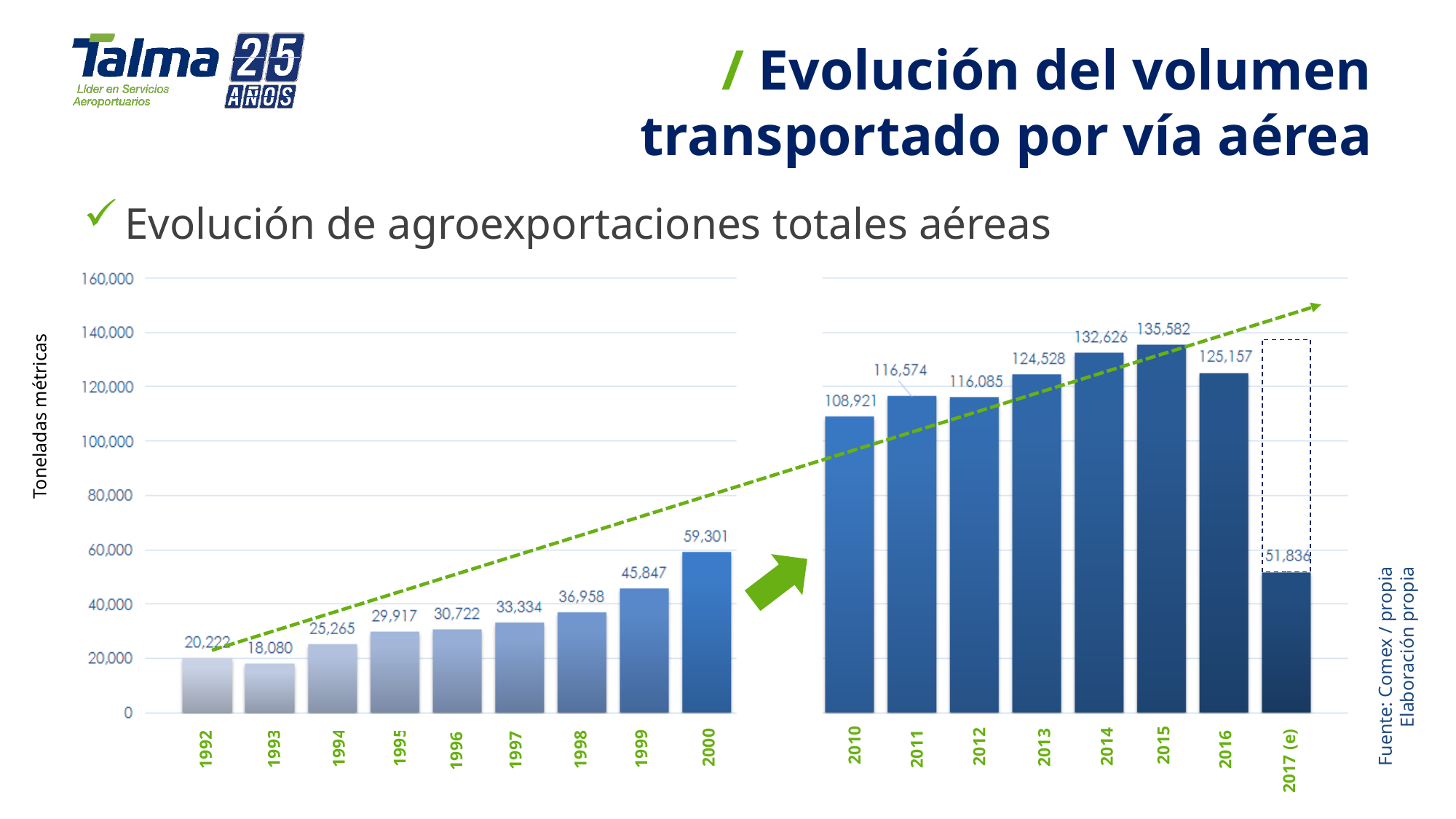
How many years are shown in the left chart (1992–2000)? 9 In the left chart (1992–2000), what is the difference between the values for 2000 and 1999? 13,454 In the left chart (1992–2000), what is the value for 1996? 30,722 In the right chart (2010–2017), what is the value for 2013? 124,528 In the right chart (2010–2017), is the value for 2010 greater or less than 100,000? greater In the right chart (2010–2017), which is larger, the value for 2014 or the value for 2016? 2014 What kind of chart is used on this slide? Bar chart In the right chart (2010–2017), what is the value for 2017 (e)? 51,836 What is the label of the vertical axis on the slide? Toneladas métricas In the right chart (2010–2017), which year has the highest value? 2015 In the left chart (1992–2000), do the values generally rise or fall from 1993 to 2000? Rise In the left chart (1992–2000), which year has the lowest value? 1993